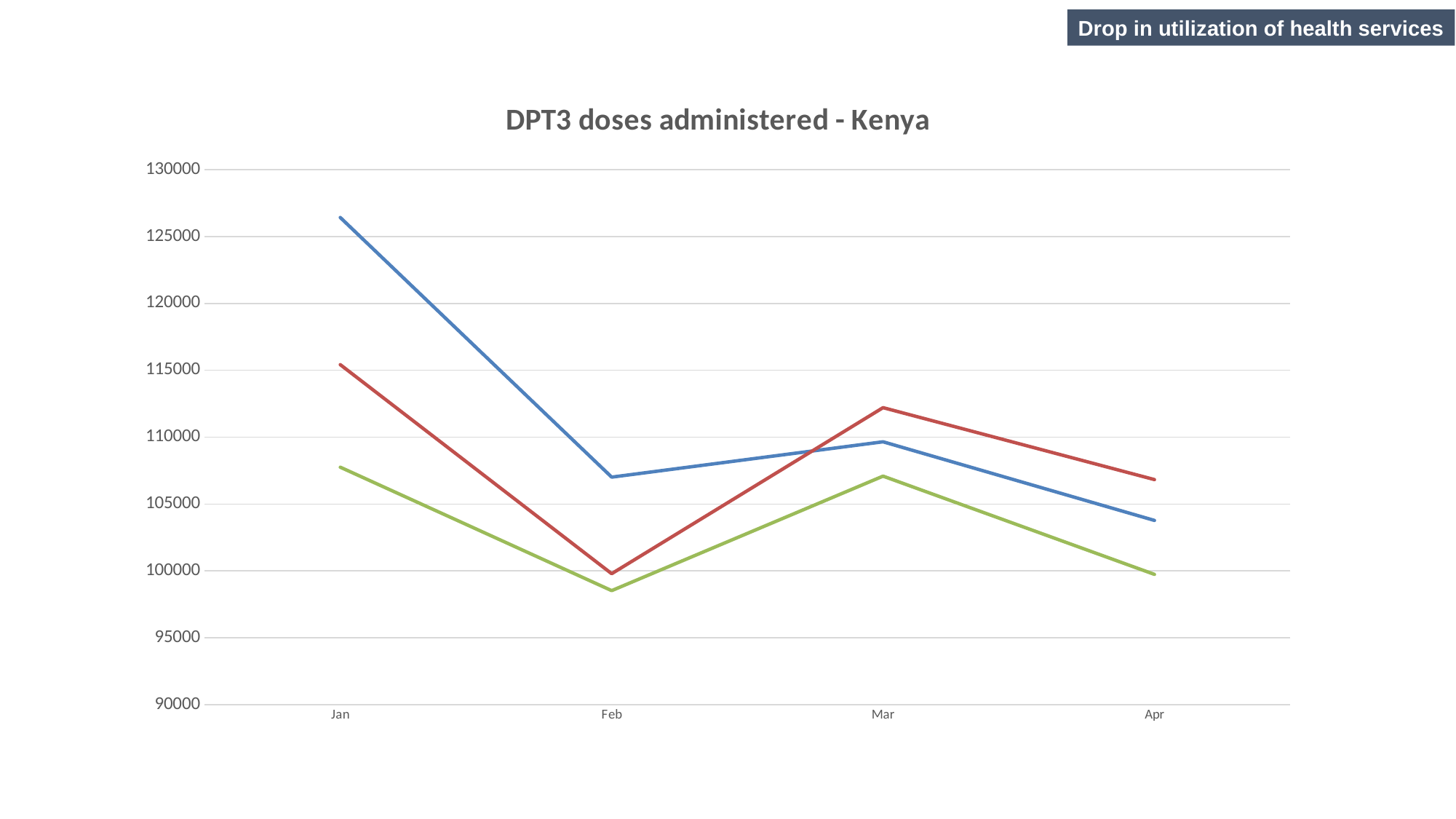
In which month does the blue line reach its highest value? Jan Is the value of the red line in Apr greater or less than 105000? greater In Mar, which line is higher, the red line or the blue line? red line What kind of chart is shown on the slide? line chart How many lines are plotted on the chart? 3 Is the value of the blue line in Jan greater or less than 125000? greater Does the blue line rise or fall from Jan to Feb? fall What is the title of the chart? DPT3 doses administered - Kenya Is the value of the blue line in Feb greater or less than 105000? greater How many months are shown on the x axis of the chart? 4 In which month does the green line reach its lowest value? Feb